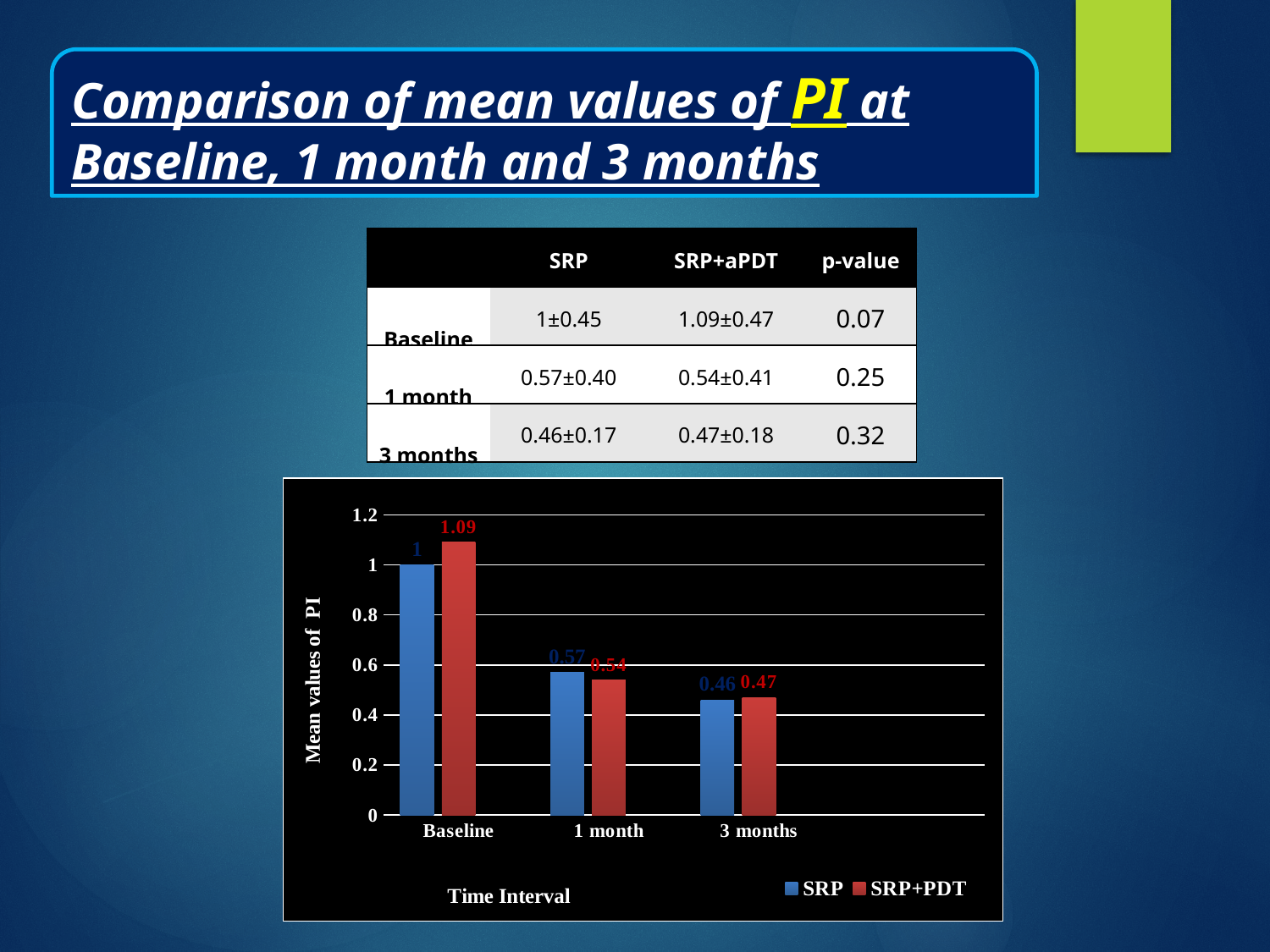
What kind of chart is shown? Bar chart What is the difference between the SRP+PDT and SRP values at Baseline? 0.09 What is the value for SRP+PDT at 3 months? 0.47 Do the SRP values rise or fall from Baseline to 3 months? Fall How many series does the legend list? 2 At which time interval is the SRP value lowest? 3 months What is the value for SRP+PDT at Baseline? 1.09 How many time intervals are shown on the x axis? 3 What is the value for SRP at Baseline? 1 What is the value for SRP at 1 month? 0.57 Which is larger at Baseline, the SRP value or the SRP+PDT value? SRP+PDT At which time interval is the SRP+PDT value highest? Baseline